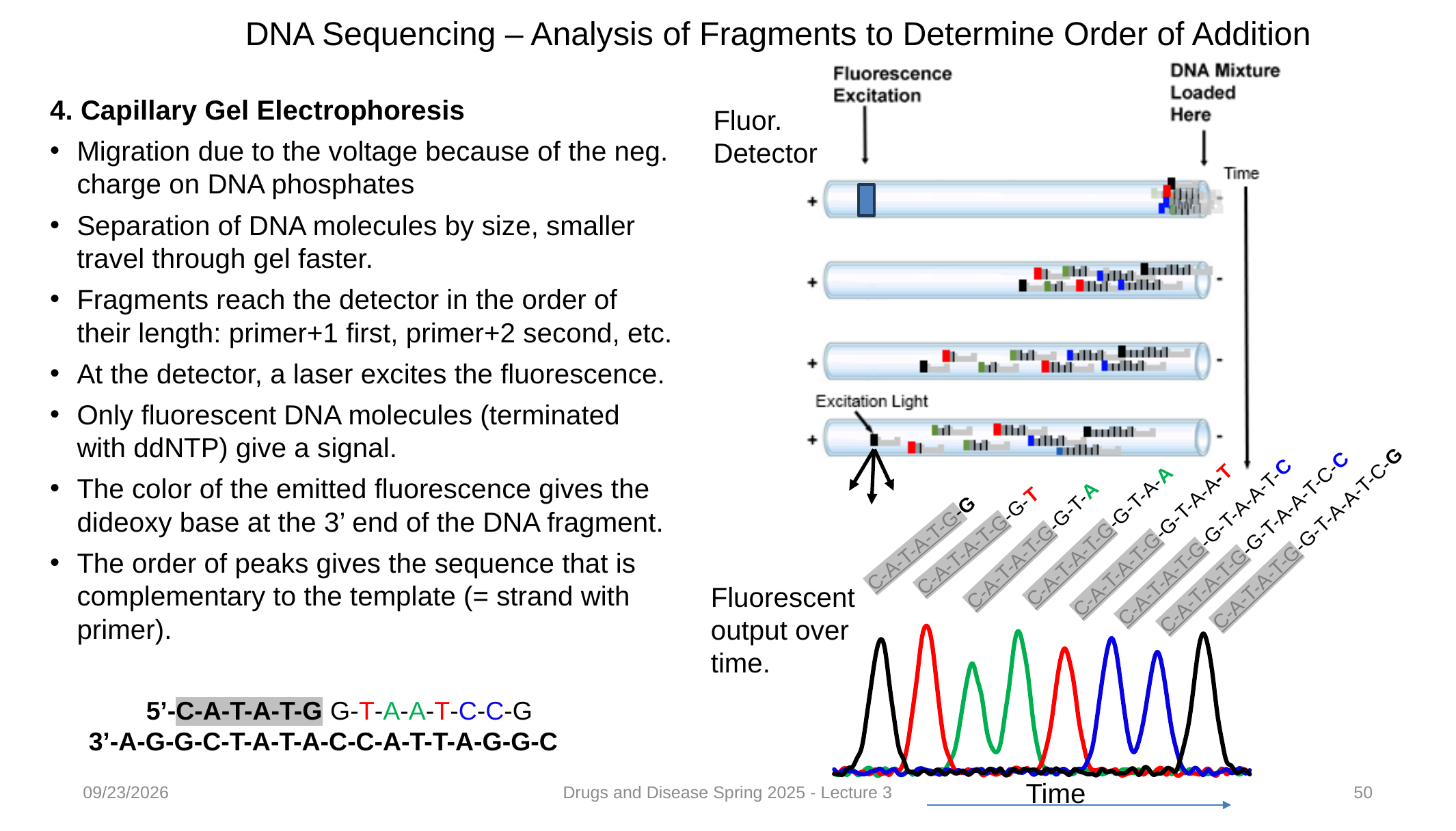
How many green peaks appear in the 'Fluorescent output over time' trace? 2 Reading the peaks of the 'Fluorescent output over time' chart from left to right, what base sequence do they give? G-T-A-A-T-C-C-G What is the label on the horizontal axis of the 'Fluorescent output over time' chart? Time How many blue peaks appear in the 'Fluorescent output over time' trace? 2 What colour is the first (leftmost) peak in the 'Fluorescent output over time' trace? black How many differently coloured traces are plotted in the 'Fluorescent output over time' chart? 4 How many peaks are shown in the 'Fluorescent output over time' trace? 8 What kind of chart is the 'Fluorescent output over time' plot at the bottom right of the slide? line chart